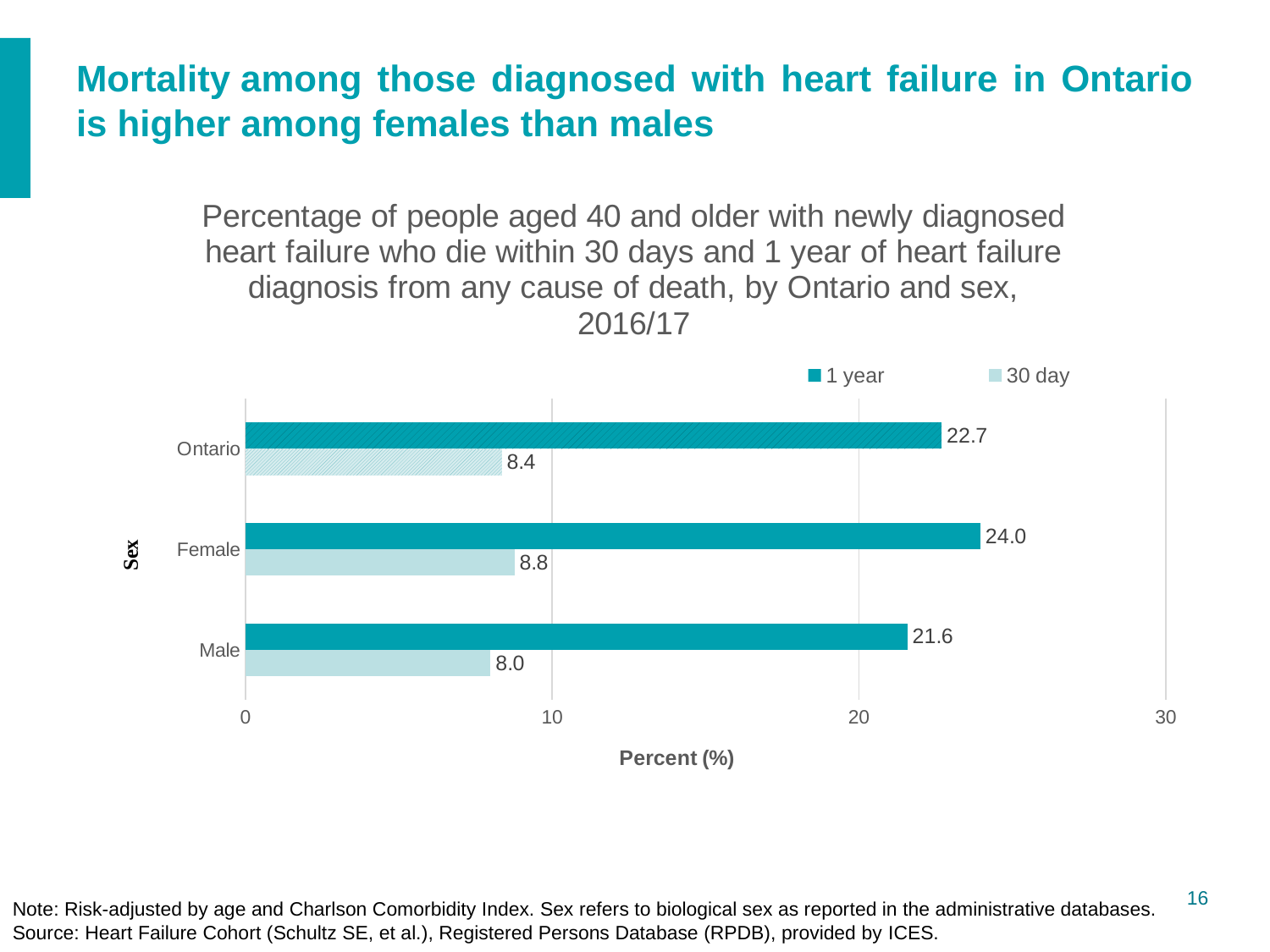
How many series does the legend list? 2 Which is larger, the 30 day value for Female or for Ontario? Female What is the 1 year mortality value for Female? 24.0 What is the difference between the 1 year values for Female and Male? 2.4 What is the 30 day mortality value for Male? 8.0 What is the label of the x axis? Percent (%) Which category has the lowest 30 day value? Male What kind of chart is shown? bar chart How many categories are shown on the y axis? 3 What is the 30 day value for Ontario? 8.4 Which category has the highest 1 year value? Female Is the 1 year value for Male greater or less than 20? greater